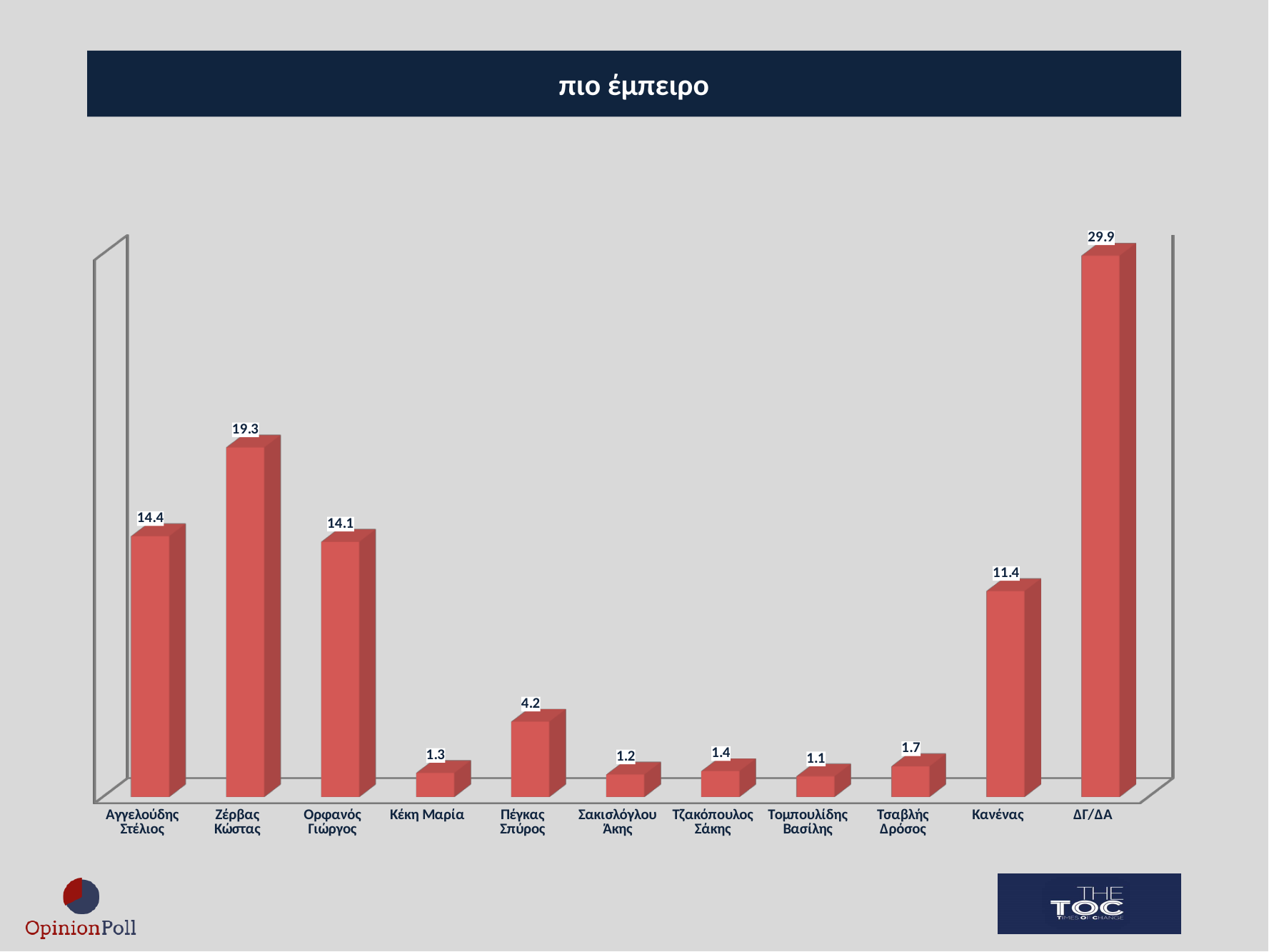
Which category has the lowest value? Τομπουλίδης Βασίλης What is the difference between the values for Ζέρβας Κώστας and Αγγελούδης Στέλιος? 4.9 Which is larger, the value for Τσαβλής Δρόσος or the value for Κέκη Μαρία? Τσαβλής Δρόσος What is the difference between the values for ΔΓ/ΔΑ and Κανένας? 18.5 Which is larger, the value for Αγγελούδης Στέλιος or the value for Ορφανός Γιώργος? Αγγελούδης Στέλιος What is the title of the chart? πιο έμπειρο What is the value for Πέγκας Σπύρος? 4.2 How many categories are shown on the chart? 11 What is the value for Κανένας? 11.4 What kind of chart is shown on the slide? Bar chart What is the value for Ζέρβας Κώστας? 19.3 Which category has the highest value? ΔΓ/ΔΑ